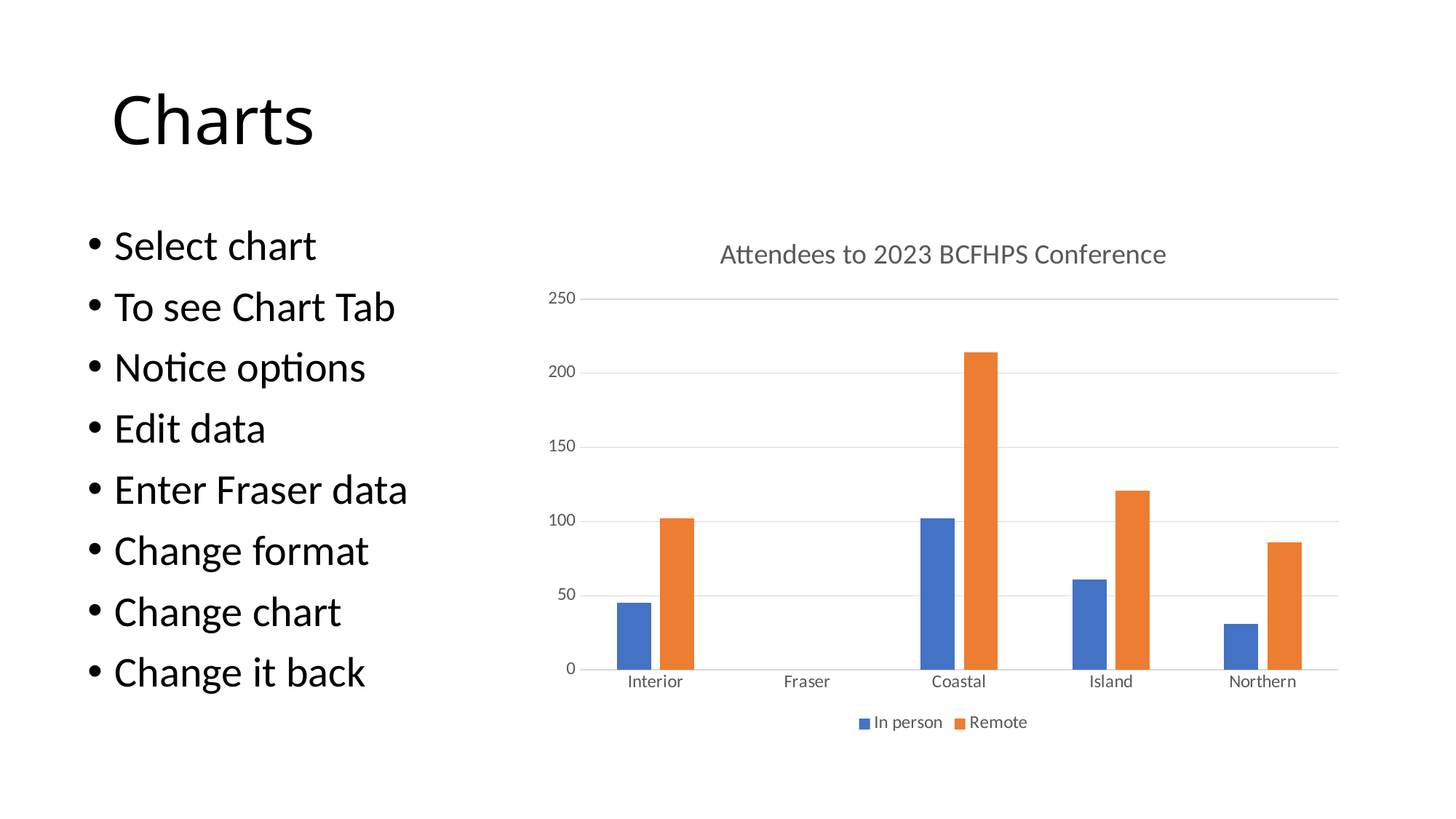
How many categories are shown on the x axis? 5 Which colour represents the Remote series in the legend? orange Is the In person value for Northern greater or less than 50? less Is the Remote value for Island greater or less than 100? greater Which is larger, the Remote value for Coastal or the Remote value for Island? Coastal What is the title of the chart? Attendees to 2023 BCFHPS Conference Is the Remote value for Coastal greater or less than 200? greater What type of chart is shown on the slide? bar chart How many series does the legend list? 2 Which category has the highest In person value? Coastal Which category has the highest Remote value? Coastal